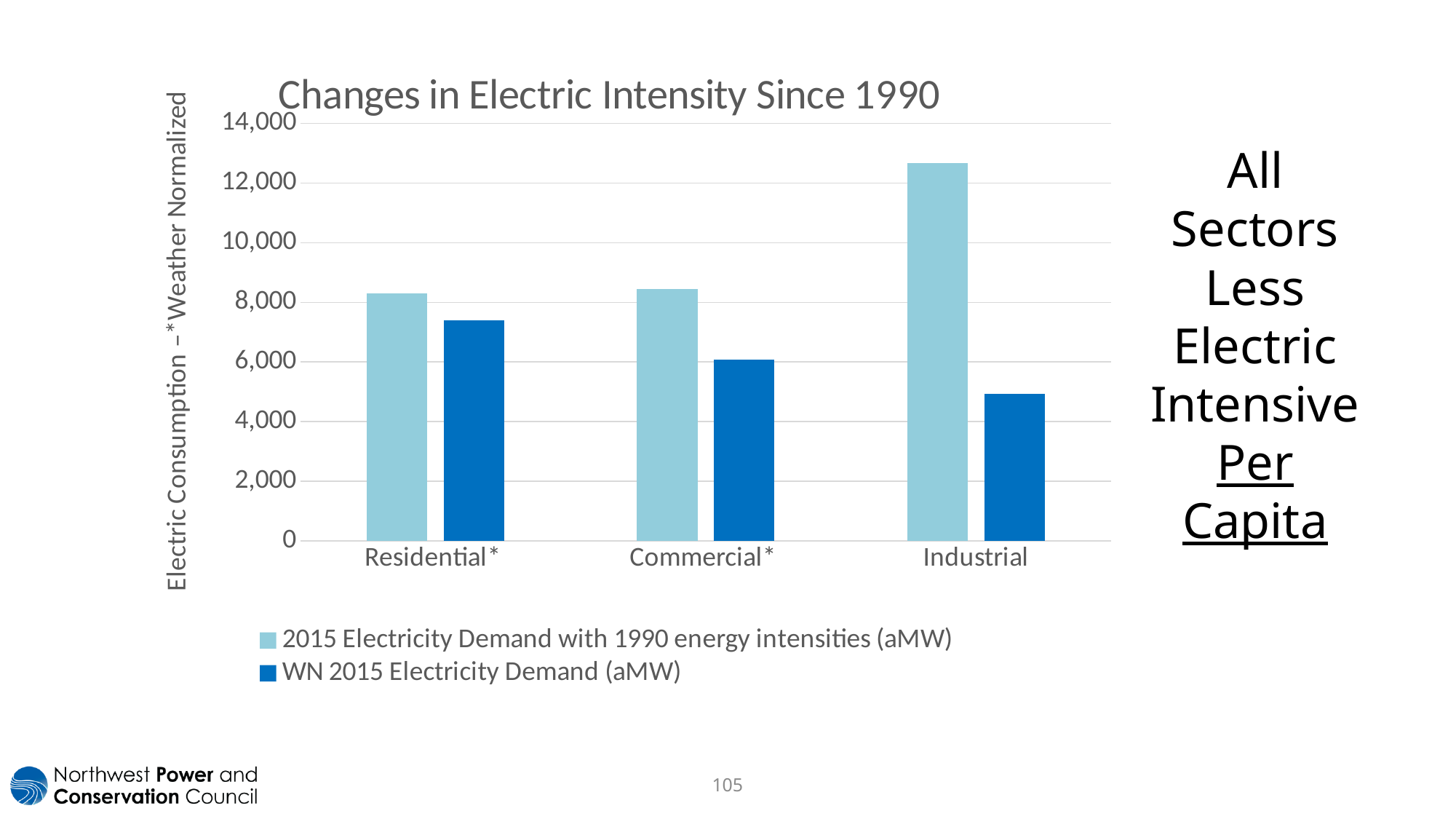
Is the value for Commercial in the 2015 Electricity Demand with 1990 energy intensities (aMW) series greater or less than 10,000? less Which sector has the highest value for 2015 Electricity Demand with 1990 energy intensities (aMW)? Industrial For the Industrial sector, which is larger: 2015 Electricity Demand with 1990 energy intensities (aMW) or WN 2015 Electricity Demand (aMW)? 2015 Electricity Demand with 1990 energy intensities (aMW) Is the value for Residential in the WN 2015 Electricity Demand (aMW) series greater or less than 6,000? greater How many sector categories are shown on the x axis? 3 Which sector has the lowest value for WN 2015 Electricity Demand (aMW)? Industrial Do the values for WN 2015 Electricity Demand (aMW) rise or fall from Residential to Industrial? fall What kind of chart is shown on the slide? bar chart How many series does the legend list? 2 What is the title of the chart? Changes in Electric Intensity Since 1990 Is the value for Industrial in the 2015 Electricity Demand with 1990 energy intensities (aMW) series greater or less than 12,000? greater